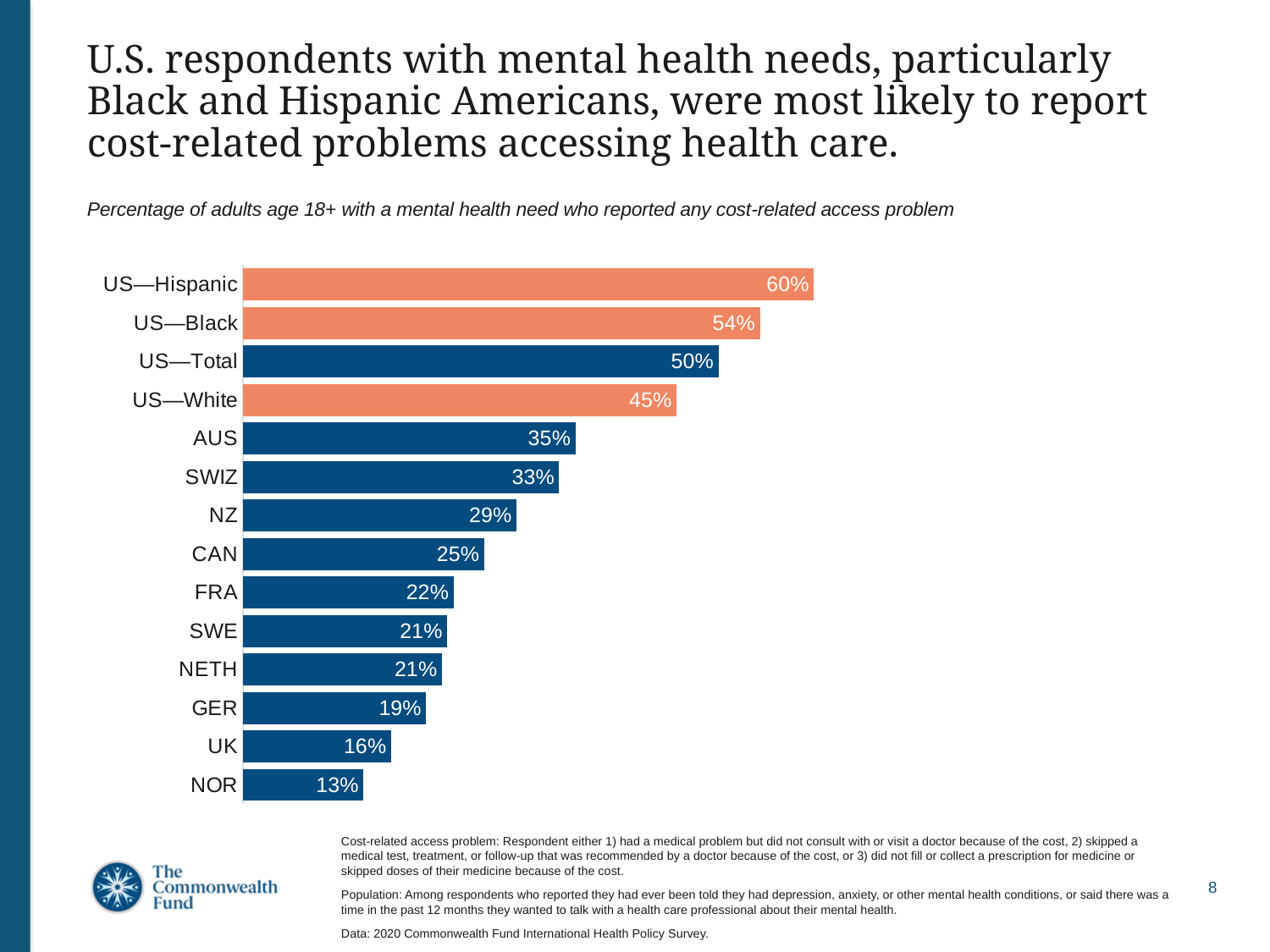
What is the value for SWIZ? 33% What is the difference between the values for US—Black and US—White? 9% How many categories are shown in the chart? 14 What kind of chart is shown on the slide? Bar chart Which category has the lowest value? NOR Which categories have bars coloured orange rather than blue? US—Hispanic, US—Black, US—White What is the difference between the values for AUS and UK? 19% Which is larger, the value for CAN or the value for FRA? CAN What is the value for US—Hispanic? 60% What is the value for GER? 19% Which category has the highest value? US—Hispanic What is the value for NOR? 13%